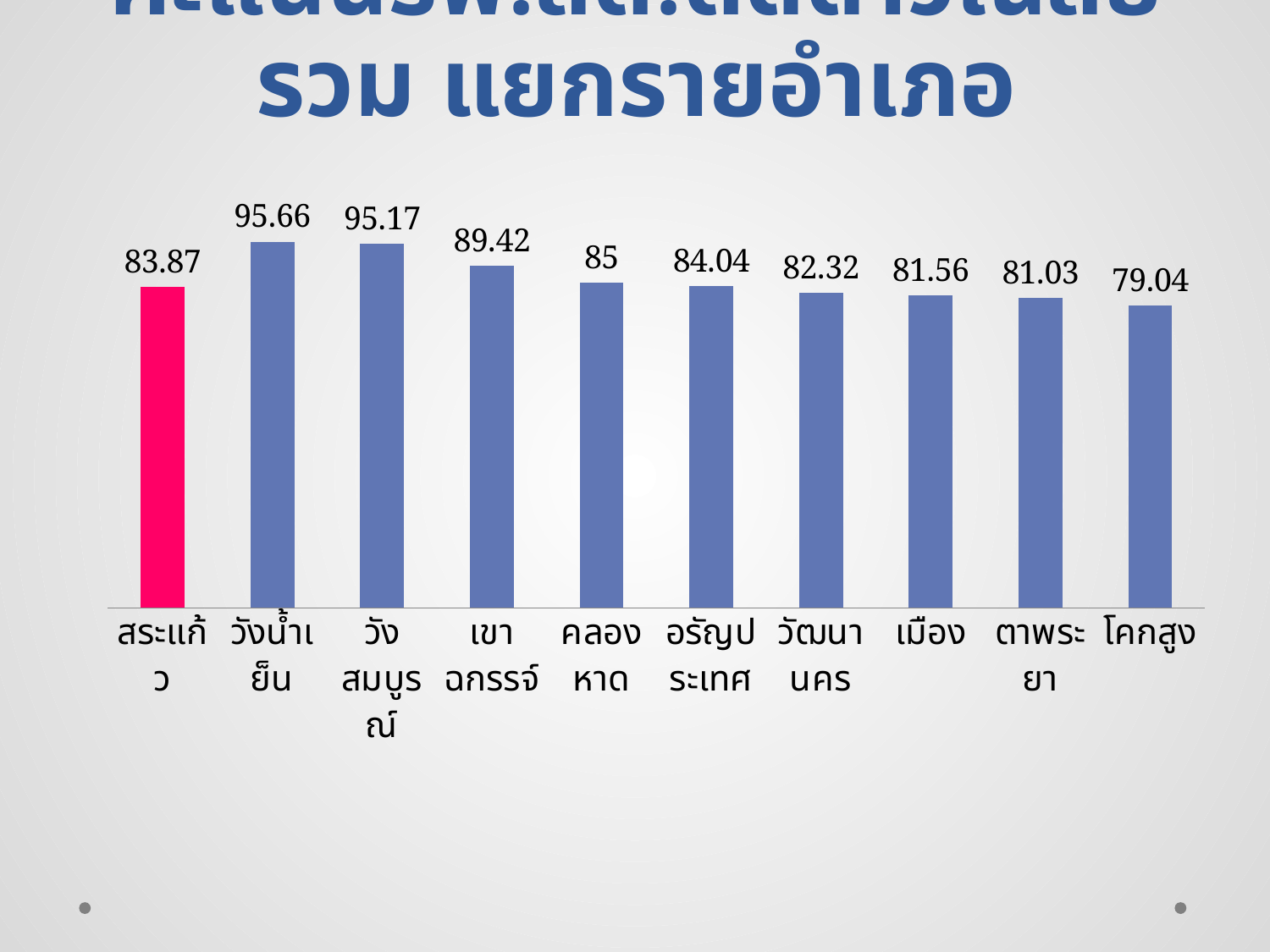
What is the difference between the values for วังน้ำเย็น and โคกสูง? 16.62 What is the value for โคกสูง? 79.04 How many bars (categories) are shown in the chart? 10 What is the value for วังน้ำเย็น? 95.66 What is the difference between the values for เขาฉกรรจ์ and คลองหาด? 4.42 Which is larger, the value for วังสมบูรณ์ or the value for เขาฉกรรจ์? วังสมบูรณ์ Which category has the lowest value? โคกสูง What is the value for คลองหาด? 85 What is the value for สระแก้ว? 83.87 Which category has the highest value? วังน้ำเย็น What type of chart is shown on the slide? bar chart Which bar is shown in a different colour (pink) from the others? สระแก้ว